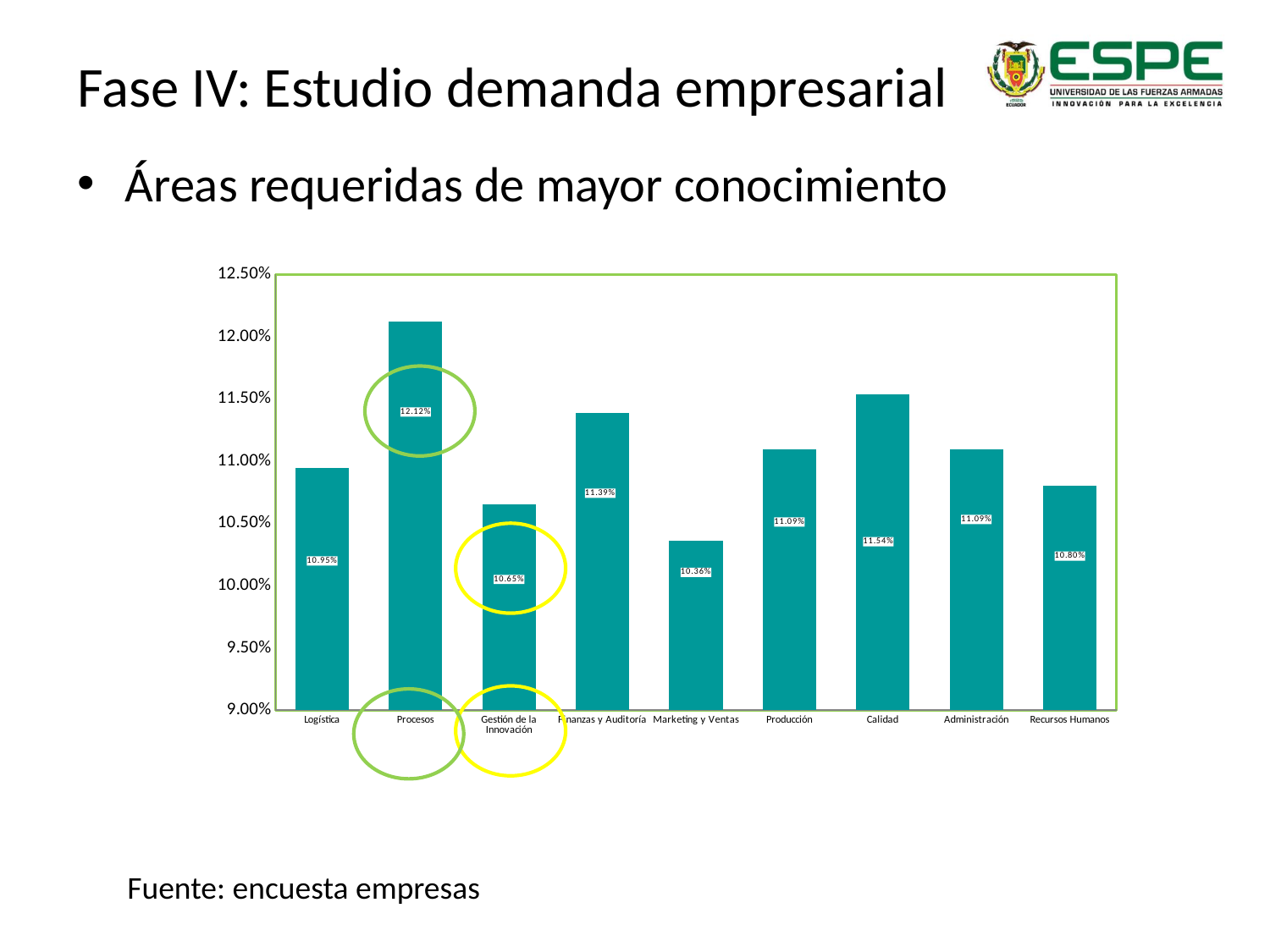
Is the value for Calidad greater or less than 11.00%? greater How many categories are shown on the x axis? 9 What kind of chart is shown on the slide? bar chart Which is larger, the value for Finanzas y Auditoría or the value for Logística? Finanzas y Auditoría Which category has the highest value? Procesos What is the difference between the values for Procesos and Gestión de la Innovación? 1.47% What is the value for Recursos Humanos? 10.80% What is the value for Calidad? 11.54% Which two categories share the same value of 11.09%? Producción and Administración What is the value for Procesos? 12.12% What is the value for Marketing y Ventas? 10.36% Which category has the lowest value? Marketing y Ventas